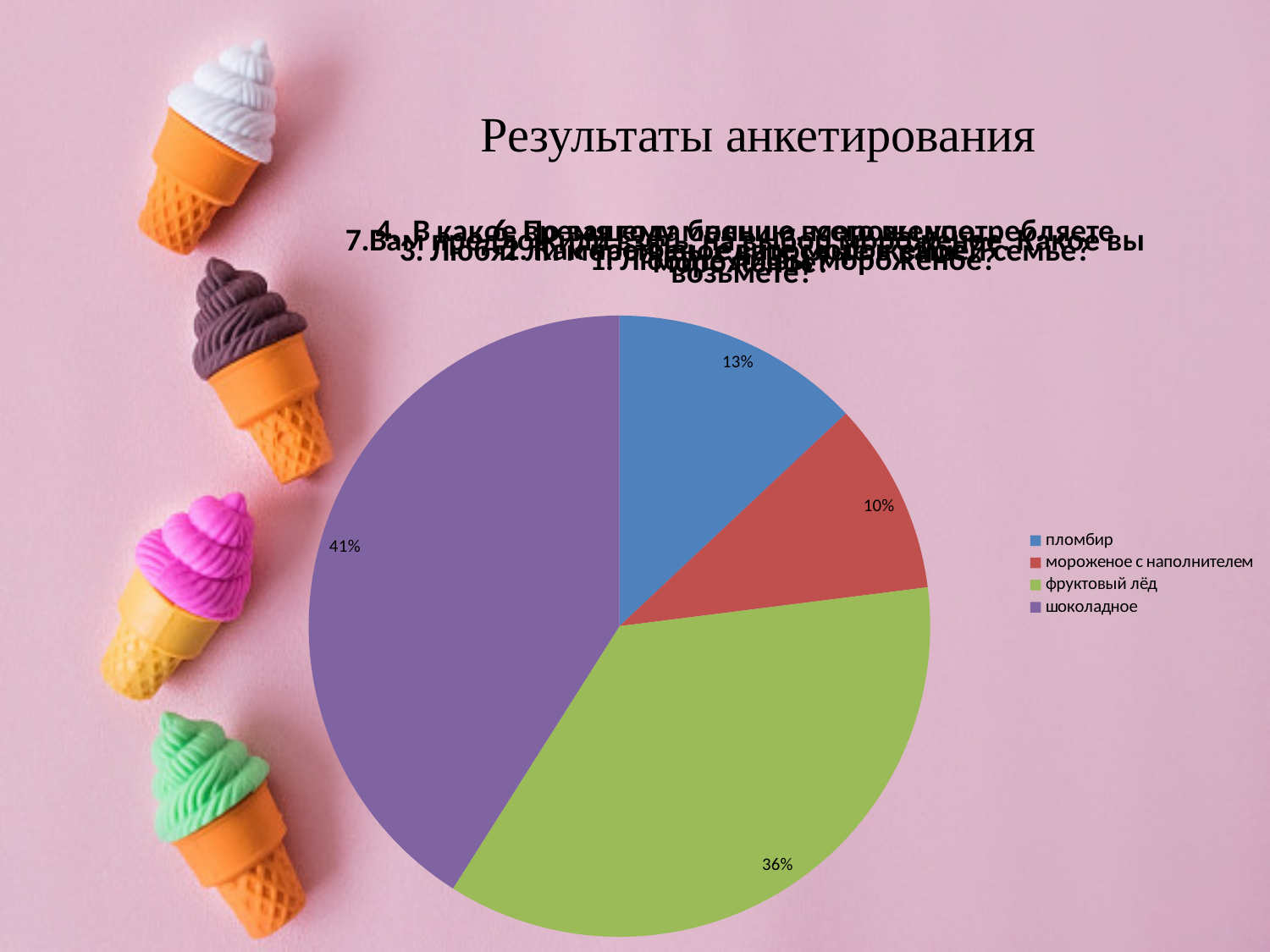
What share of the pie does фруктовый лёд have? 36% What colour is the slice for фруктовый лёд? green What kind of chart is shown on the slide? pie chart Which is larger, the slice for пломбир or the slice for мороженое с наполнителем? пломбир What share of the pie does шоколадное have? 41% What share of the pie does пломбир have? 13% How many categories does the pie chart have? 4 How many entries does the legend list? 4 Which category has the largest slice of the pie? шоколадное What is the difference in percentage points between шоколадное and фруктовый лёд? 5 What share of the pie does мороженое с наполнителем have? 10% Which category has the smallest slice of the pie? мороженое с наполнителем